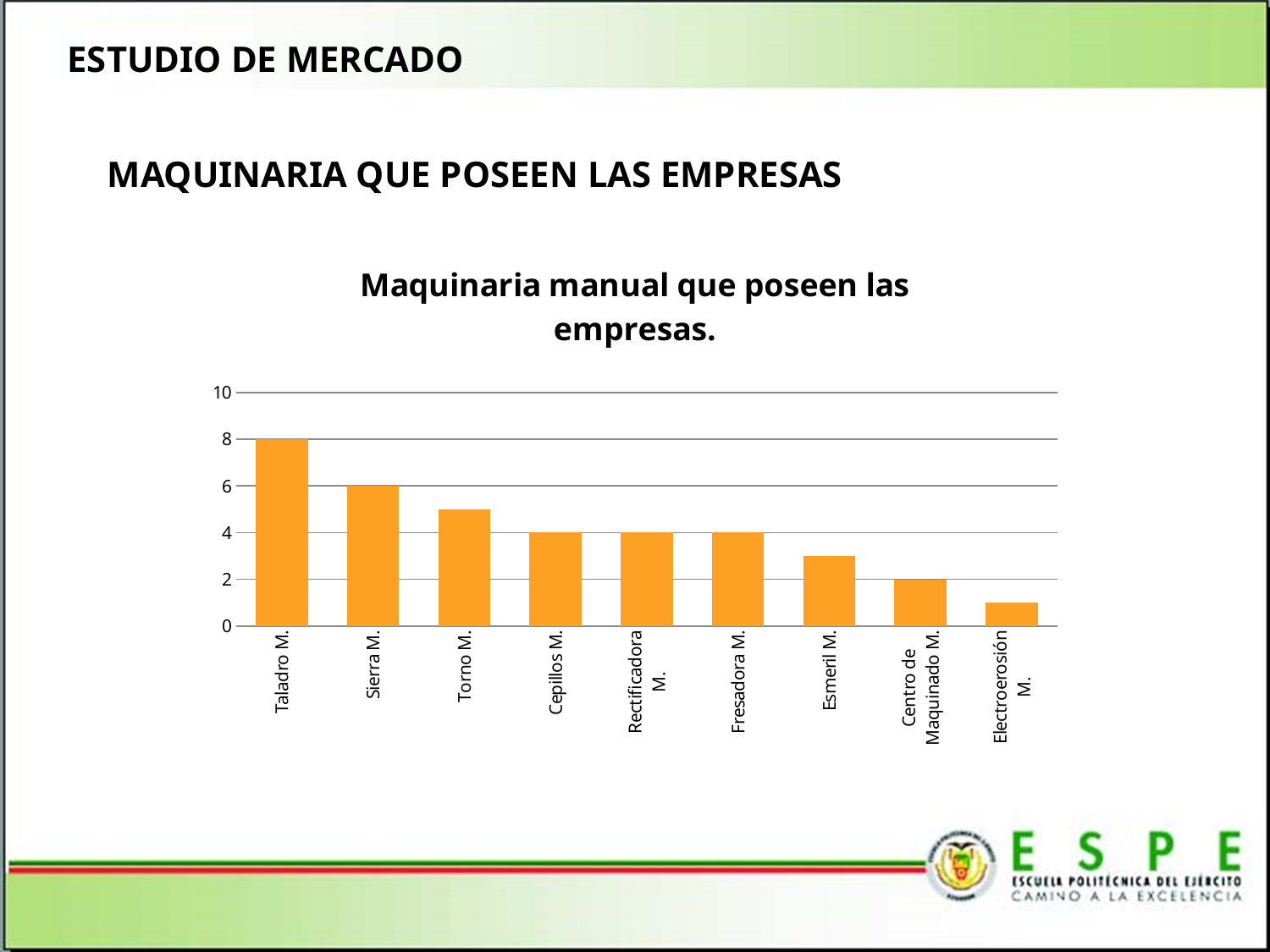
Is the value for Esmeril M. greater or less than 4? less What is the difference between the values for Taladro M. and Sierra M.? 2 Which category has the lowest value? Electroerosión M. Is the value for Torno M. greater or less than 4? greater Which category has the highest value? Taladro M. Do the values rise or fall from left to right along the x axis? fall What is the value for Sierra M.? 6 What is the value for Centro de Maquinado M.? 2 What kind of chart is shown on the slide? bar chart What is the title of the chart? Maquinaria manual que poseen las empresas. What is the value for Taladro M.? 8 How many categories are plotted in the chart? 9